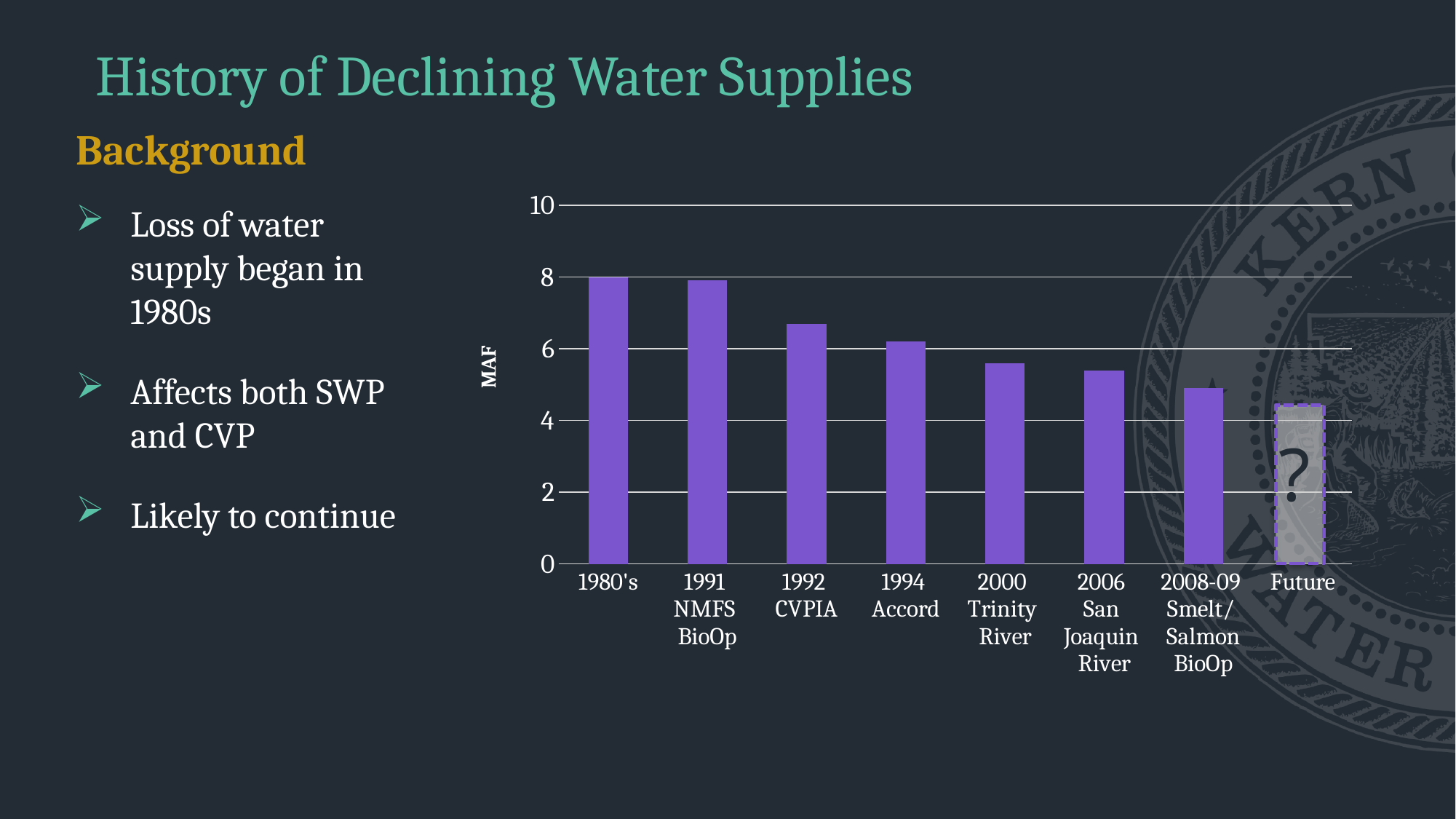
How many categories are shown along the x axis of the chart? 8 Is the value for 2000 Trinity River greater or less than 6? less What kind of chart is shown on the slide? bar chart Which is larger, the value for 1992 CVPIA or the value for 1994 Accord? 1992 CVPIA Which category has the tallest bar in the chart? 1980's Is the value for 1992 CVPIA greater or less than 6? greater What label is shown on the vertical axis of the chart? MAF Is the value for 1991 NMFS BioOp greater or less than 6? greater Do the values rise or fall moving from left to right along the x axis? fall What is the value for 1980's in MAF? 8